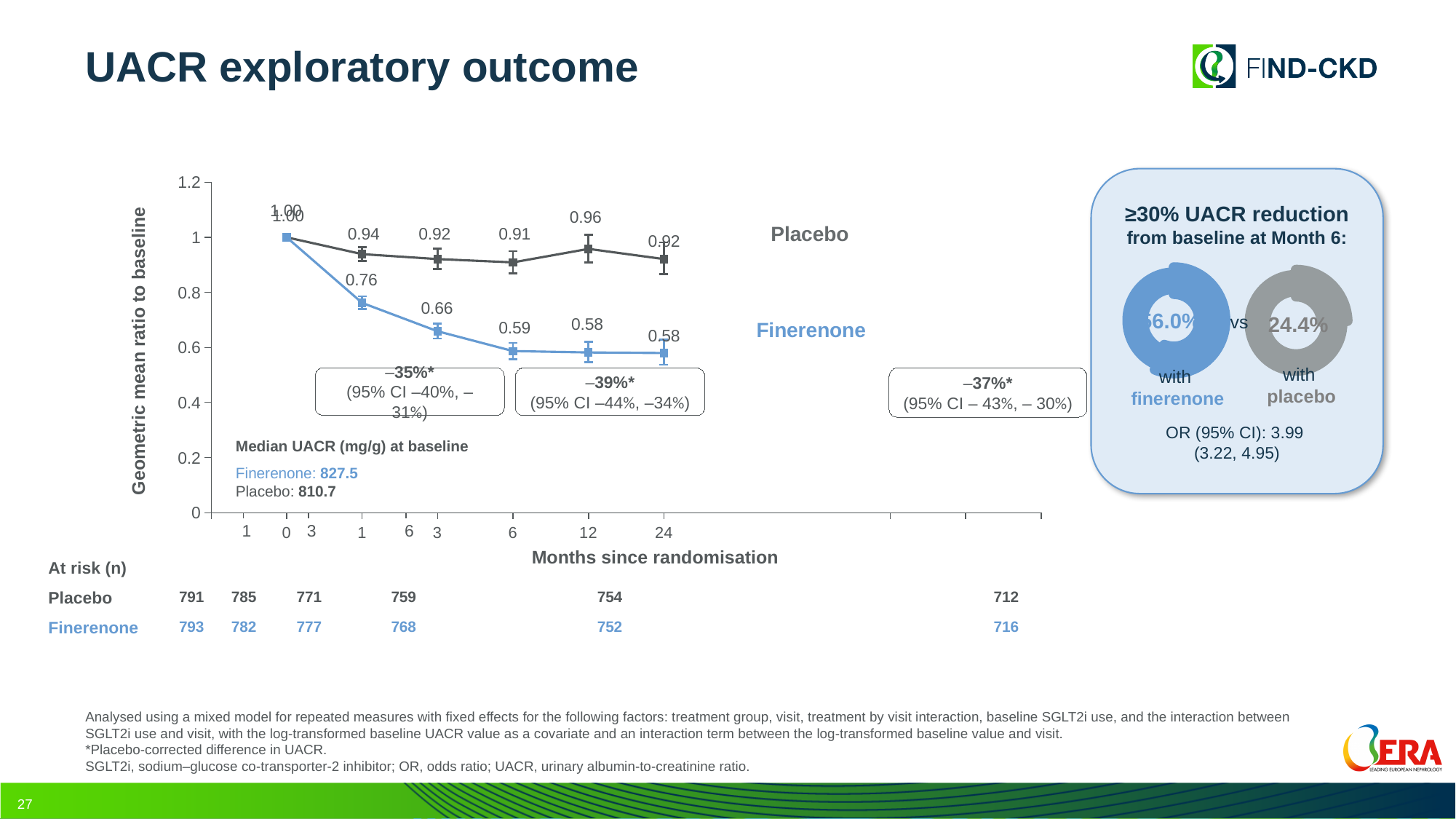
In the line chart, does the Finerenone series rise or fall from month 0 to month 6? fall In the line chart, how many time points are plotted for each series? 6 In the line chart, which series has the higher value at month 24, Placebo or Finerenone? Placebo In the line chart, at which month does Finerenone reach its lowest value for the first time? 12 In the line chart, what is the difference between the Placebo and Finerenone values at month 3? 0.26 In the donut charts on the right, what percentage of placebo patients had a ≥30% UACR reduction from baseline at Month 6? 24.4% In the line chart, what is the geometric mean ratio to baseline for Placebo at month 24? 0.92 How many series are plotted in the line chart? 2 What type of chart is used to show the geometric mean ratio to baseline over months since randomisation? line chart In the line chart, what is the geometric mean ratio to baseline for Placebo at month 12? 0.96 In the line chart, what is the geometric mean ratio to baseline for Finerenone at month 1? 0.76 In the line chart, what is the geometric mean ratio to baseline for Finerenone at month 6? 0.59